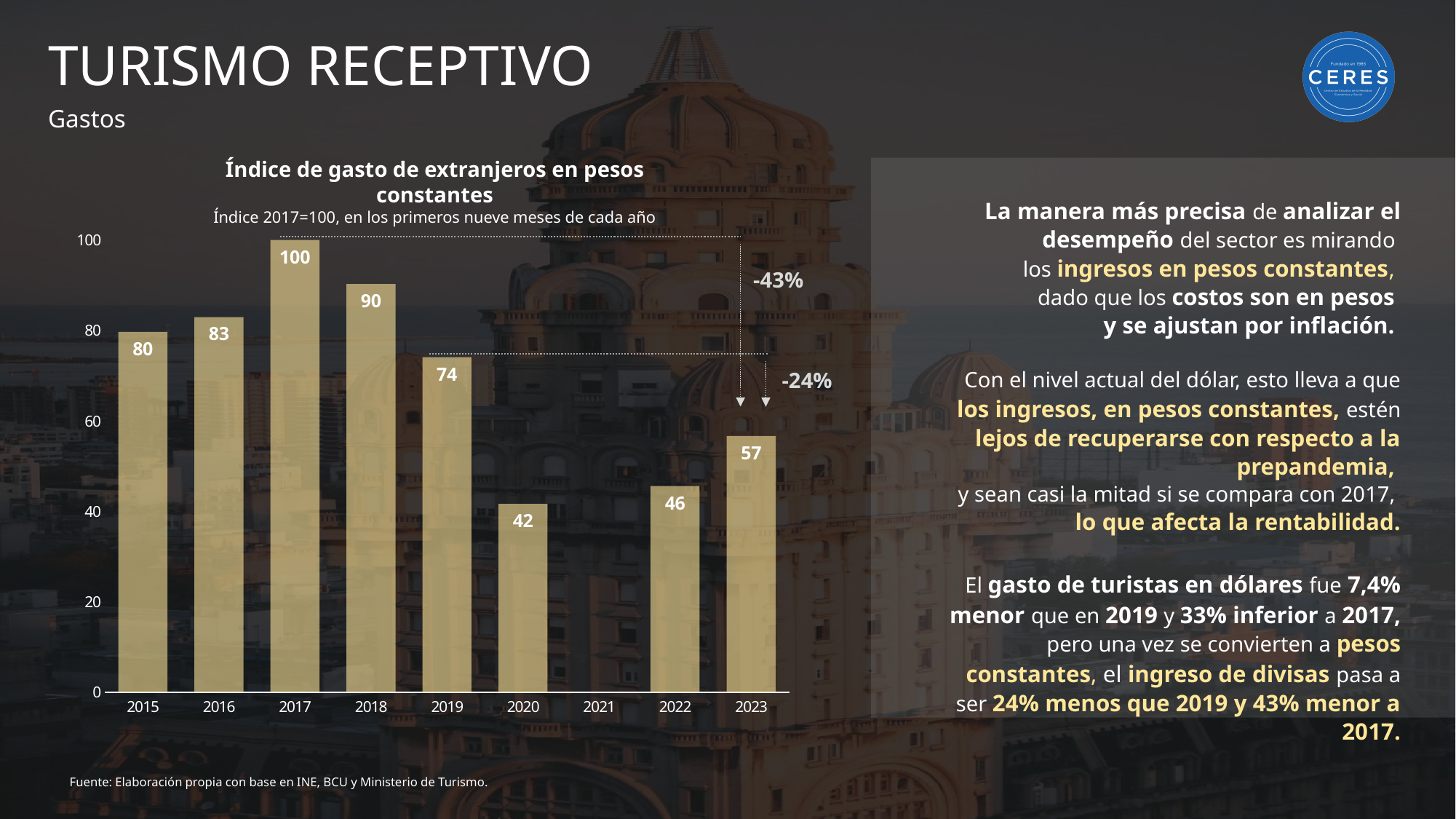
What is the index value for 2017? 100 Which year has the highest index value? 2017 What is the title of the chart? Índice de gasto de extranjeros en pesos constantes What is the index value for 2023? 57 Which year has the lowest index value among the plotted bars? 2020 Is the value for 2022 greater or less than 60? less What is the index value for 2020? 42 What kind of chart is shown on the slide? bar chart What is the difference between the index values for 2019 and 2022? 28 What is the difference between the index values for 2017 and 2023? 43 Which year has a larger index value, 2016 or 2018? 2018 How many bars are plotted in the chart? 8